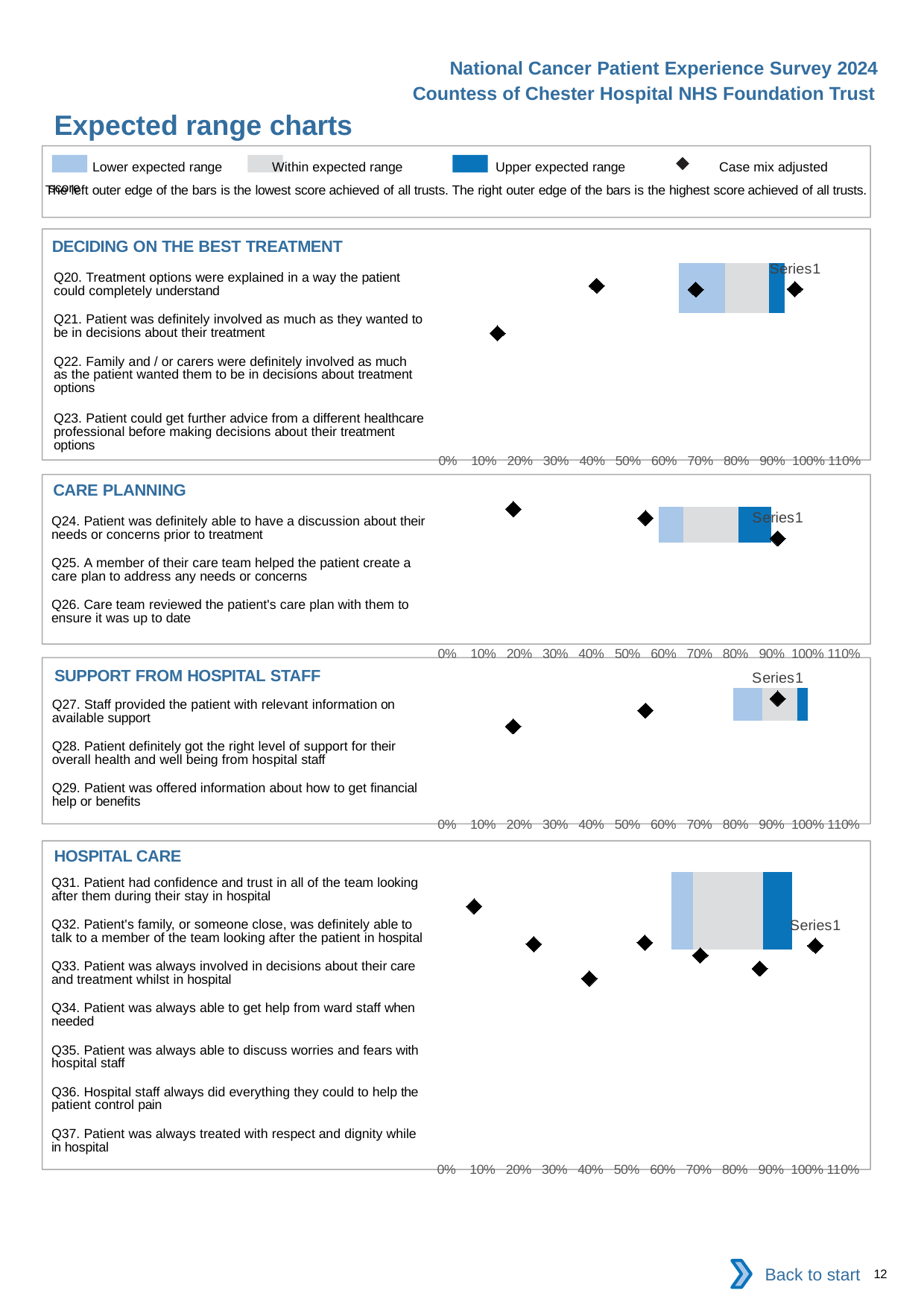
What is the last question listed in the 'SUPPORT FROM HOSPITAL STAFF' chart? Q29. Patient was offered information about how to get financial help or benefits What is the first question listed in the 'HOSPITAL CARE' chart? Q31. Patient had confidence and trust in all of the team looking after them during their stay in hospital What is the highest tick label on the x axis of the 'CARE PLANNING' chart? 110% What kind of chart is used in the 'HOSPITAL CARE' section? Bar chart How many expected range charts are shown on the slide? 4 How many questions are listed in the 'HOSPITAL CARE' chart? 7 How many questions are listed in the 'DECIDING ON THE BEST TREATMENT' chart? 4 How many entries does the legend at the top of the slide list? 4 Which legend entry is represented by a diamond marker? Case mix adjusted score